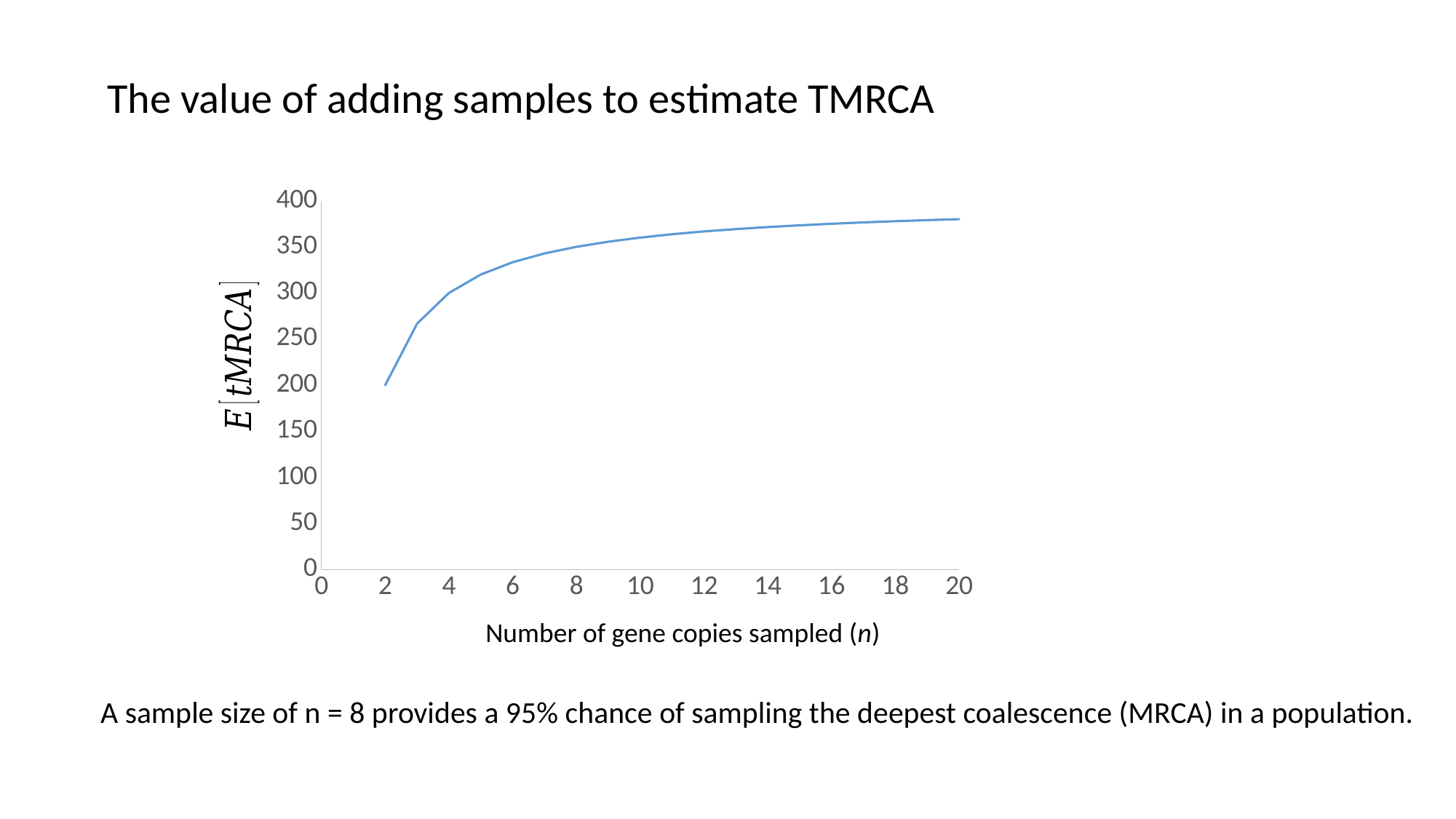
At which number of gene copies sampled is E[tMRCA] highest? 20 Does E[tMRCA] rise or fall as the number of gene copies sampled increases? rise Is the value of E[tMRCA] at n = 20 greater or less than 400? less What is the label of the x axis? Number of gene copies sampled (n) At which number of gene copies sampled is E[tMRCA] lowest? 2 Is the value of E[tMRCA] at n = 2 greater or less than 250? less What is the title of the slide containing the chart? The value of adding samples to estimate TMRCA Is the value of E[tMRCA] at n = 20 greater or less than 350? greater Which is larger, E[tMRCA] at n = 4 or at n = 12? n = 12 What kind of chart is shown on the slide? line chart